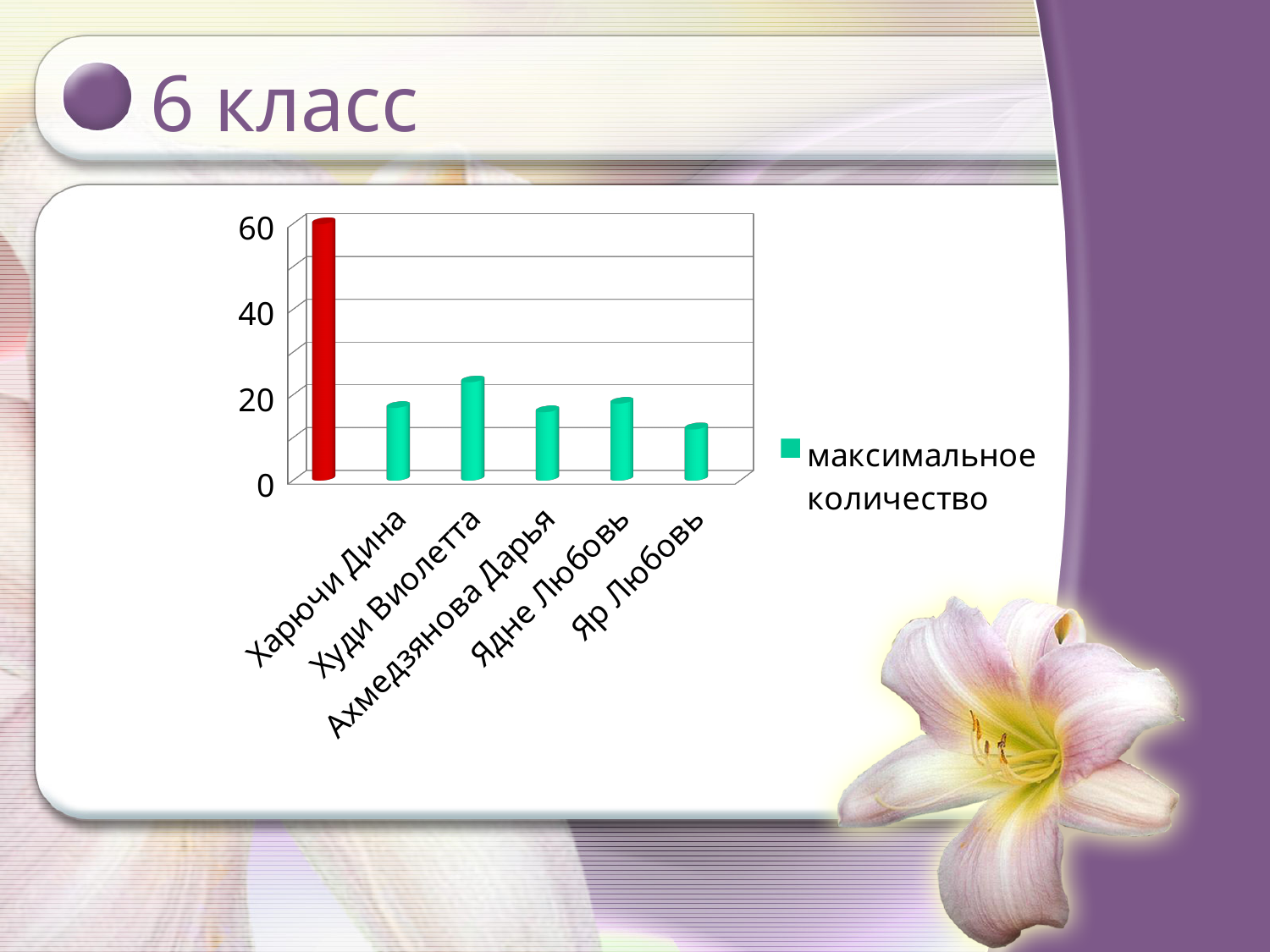
What value does the red bar reach on the vertical axis? 60 Is the value for Яр Любовь greater or less than 20? less What is the legend entry of the chart? максимальное количество How many bars are plotted in the chart? 6 Among the named students, who has the highest bar? Худи Виолетта Which is larger, the value for Худи Виолетта or the value for Ахмедзянова Дарья? Худи Виолетта Is the value for Худи Виолетта greater or less than 20? greater How many series does the legend list? 1 Which is larger, the value for Ядне Любовь or the value for Яр Любовь? Ядне Любовь What kind of chart is shown on the slide? bar chart Among the named students, who has the lowest bar? Яр Любовь What colour is the first (tallest) bar in the chart? red